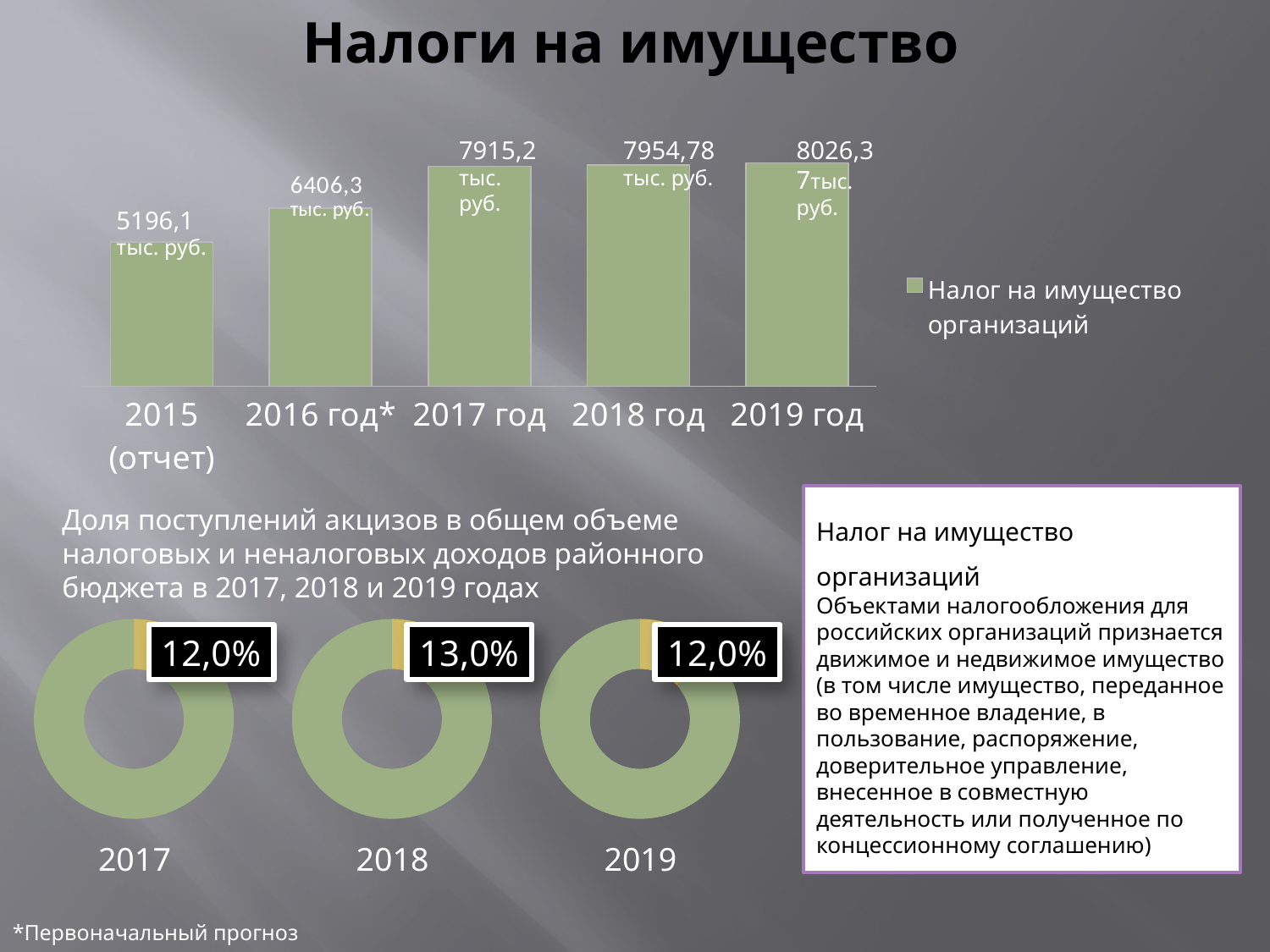
On the bar chart, what is the value for 2015 (отчет)? 5196,1 тыс. руб. On the bar chart, how many bars are shown? 5 On the bar chart, do the values rise or fall from 2015 to 2019? Rise On the bar chart, what is the value for 2018 год? 7954,78 тыс. руб. Comparing the donut charts, is the share for 2018 larger or smaller than the share for 2019? Larger On the bar chart, which year has the lowest value? 2015 (отчет) On the bar chart, how many series does the legend list? 1 What type of chart is the top chart on the slide? Bar chart On the bar chart, what is the value for 2017 год? 7915,2 тыс. руб. On the bar chart, what is the value for 2016 год*? 6406,3 тыс. руб. On the donut chart for 2018, what share is shown? 13,0% On the bar chart, what is the difference between the values for 2016 год* and 2015 (отчет)? 1210,2 тыс. руб.